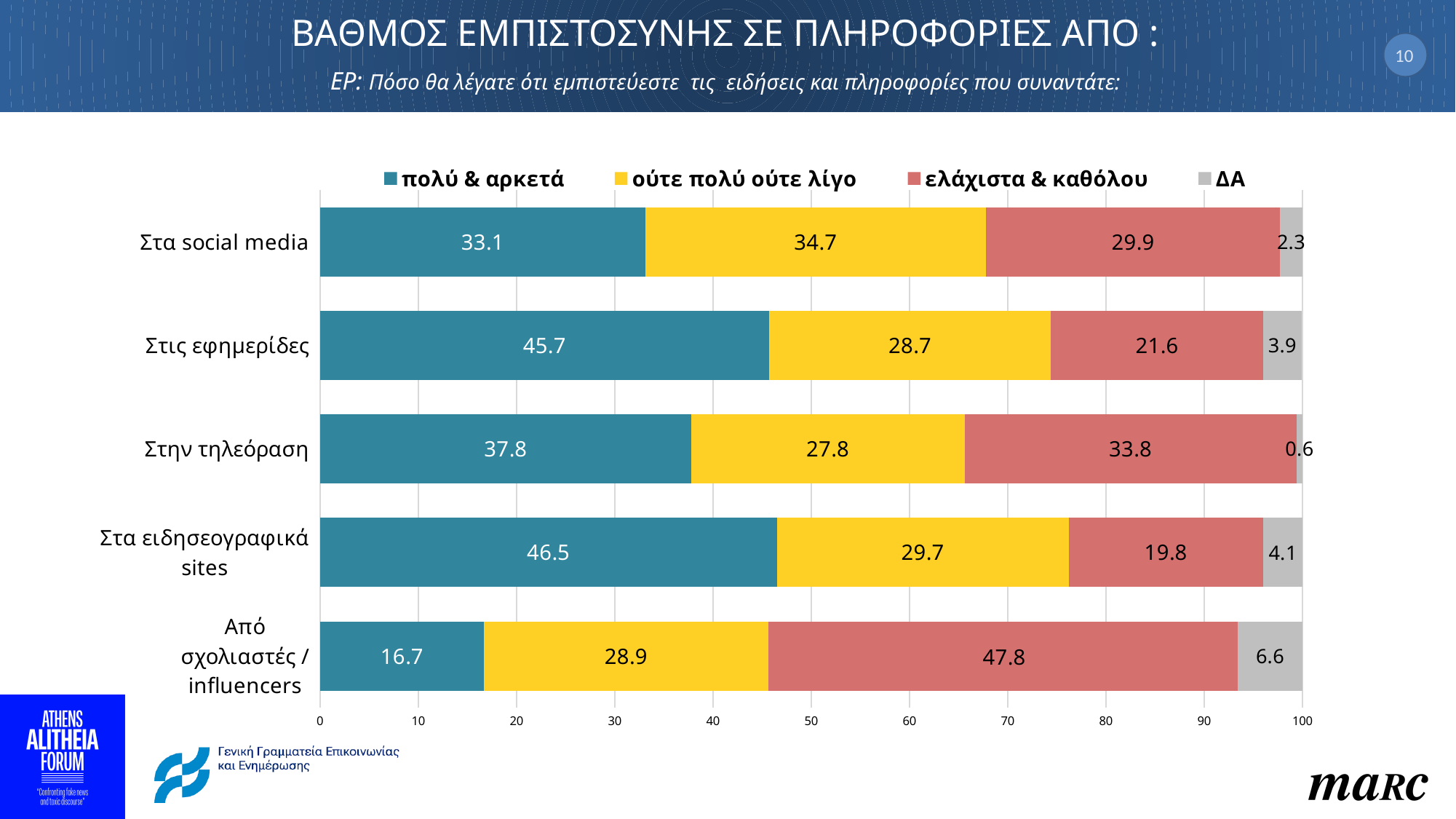
Which category has the lowest value for "πολύ & αρκετά"? Από σχολιαστές / influencers How many categories are shown on the chart? 5 Which is larger: the "ούτε πολύ ούτε λίγο" value for "Στα social media" or for "Στις εφημερίδες"? Στα social media What is the difference between the "πολύ & αρκετά" values for "Στις εφημερίδες" and "Στην τηλεόραση"? 7.9 How many series does the legend list? 4 Which category has the highest value for "πολύ & αρκετά"? Στα ειδησεογραφικά sites What kind of chart is shown on the slide? Stacked bar chart What is the value of "ελάχιστα & καθόλου" for "Από σχολιαστές / influencers"? 47.8 Which category has the highest value for "ελάχιστα & καθόλου"? Από σχολιαστές / influencers What is the value of "πολύ & αρκετά" for "Στα social media"? 33.1 What is the value of "ΔΑ" for "Στην τηλεόραση"? 0.6 What is the total of the stacked bar for "Στα social media"? 100.0